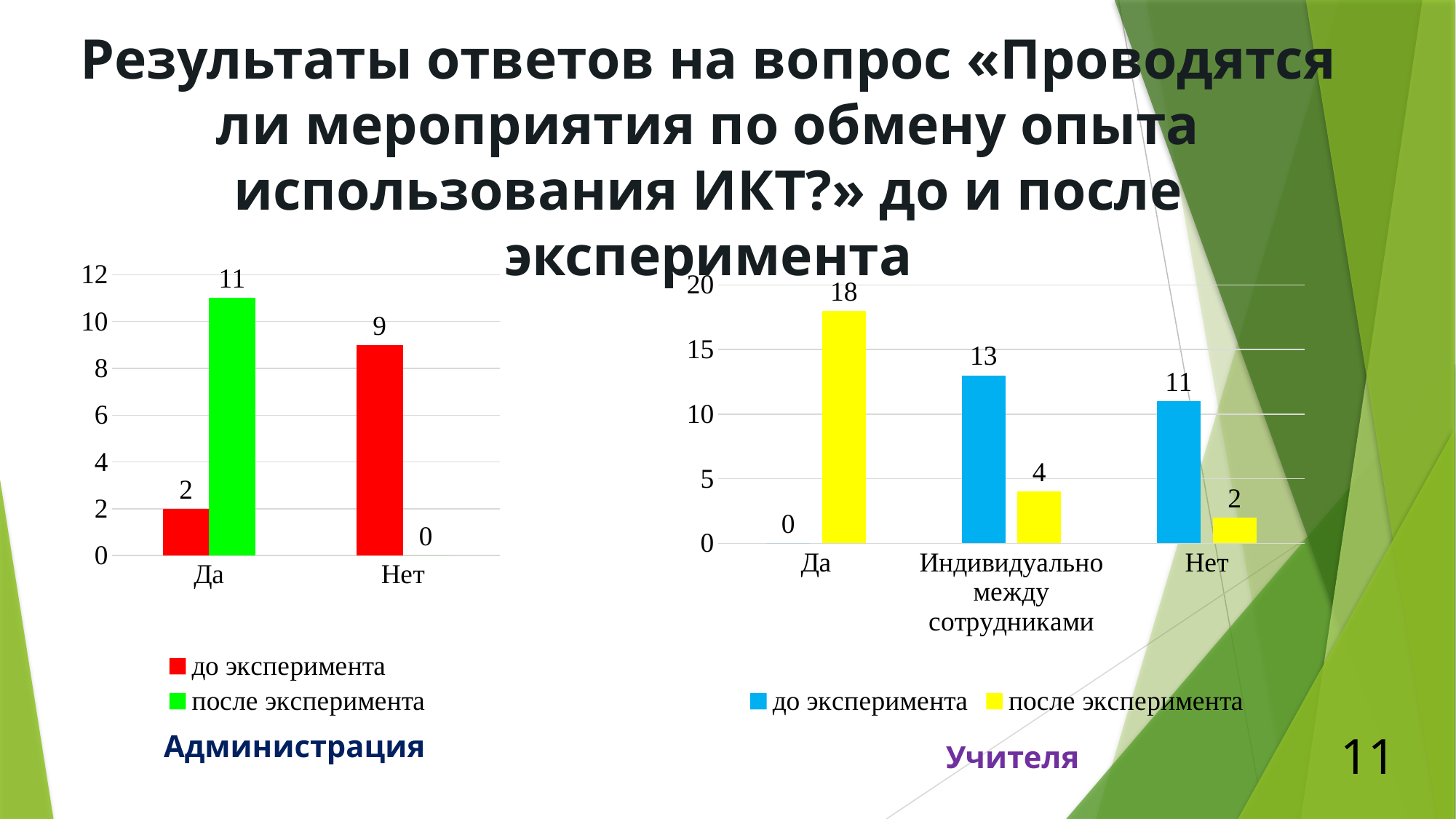
What type of chart is the Учителя chart? bar chart In the Учителя chart, what is the value for Индивидуально между сотрудниками in the до эксперимента series? 13 In the Администрация chart, what is the value for Да in the до эксперимента series? 2 In the Учителя chart, what is the difference between the до эксперимента and после эксперимента values for Нет? 9 In the Администрация chart, what is the value for Нет in the после эксперимента series? 0 How many categories are shown on the x axis of the Учителя chart? 3 In the Учителя chart, which category has the lowest value in the после эксперимента series? Нет In the Администрация chart, what is the difference between the после эксперимента and до эксперимента values for Да? 9 In the Учителя chart, what is the value for Да in the после эксперимента series? 18 In the Администрация chart, which category has the highest value in the до эксперимента series? Нет In the Учителя chart, which is larger: the до эксперимента value for Индивидуально между сотрудниками or the до эксперимента value for Нет? Индивидуально между сотрудниками How many series does the legend of the Администрация chart list? 2